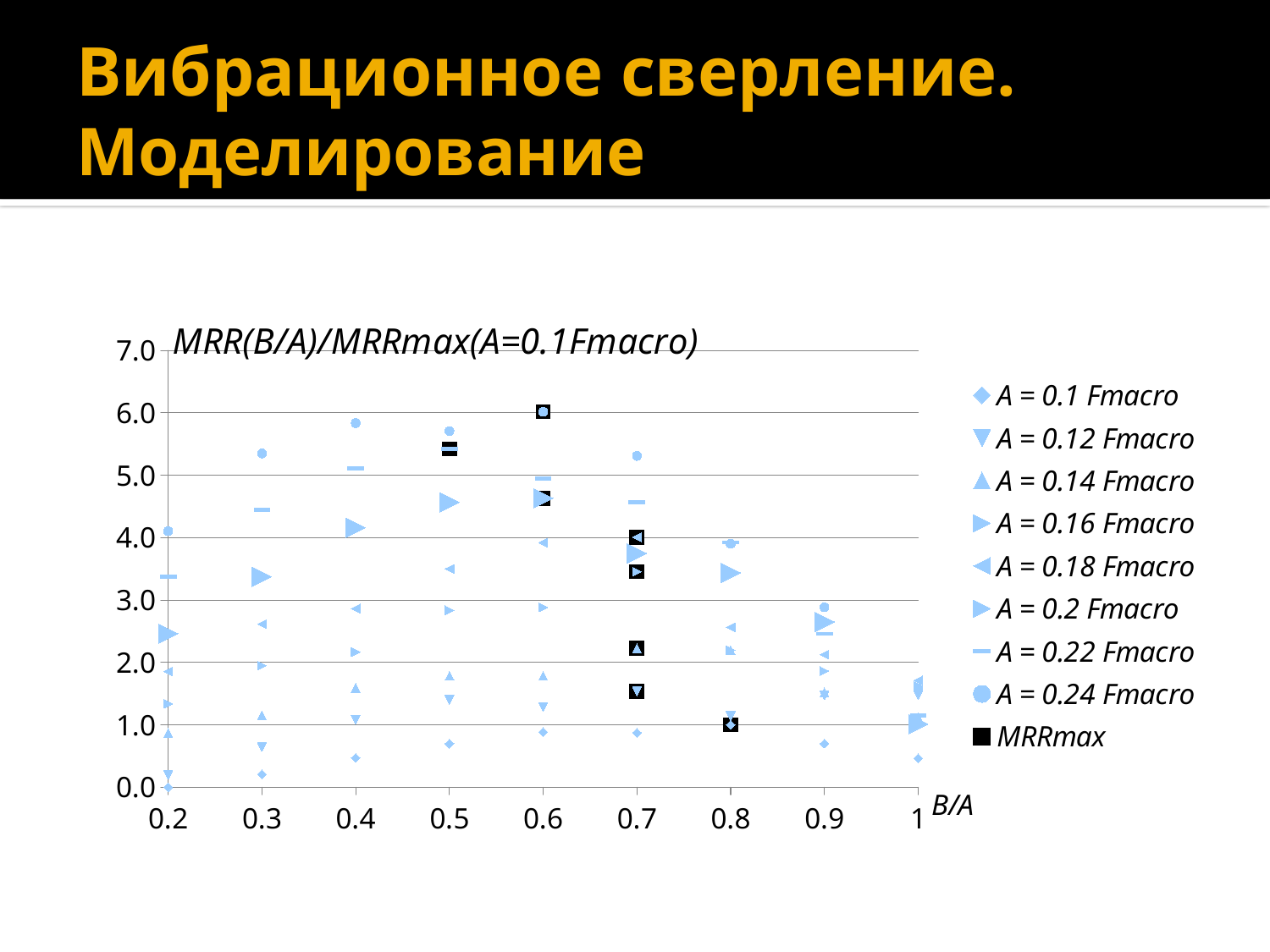
Is the value for A = 0.2 Fmacro at B/A = 0.5 greater or less than 4.0? greater What is the title of the chart? MRR(B/A)/MRRmax(A=0.1Fmacro) How many B/A values are marked on the x axis of the chart? 9 Is the value for A = 0.24 Fmacro at B/A = 0.4 greater or less than 5.0? greater What kind of chart is shown on the slide? scatter chart Is the value for A = 0.1 Fmacro at B/A = 0.3 greater or less than 1.0? less Which series has the lowest values on the chart? A = 0.1 Fmacro What is the label of the x axis of the chart? B/A How many series does the chart legend list? 9 At B/A = 0.4, which is larger: the value for A = 0.24 Fmacro or the value for A = 0.1 Fmacro? A = 0.24 Fmacro